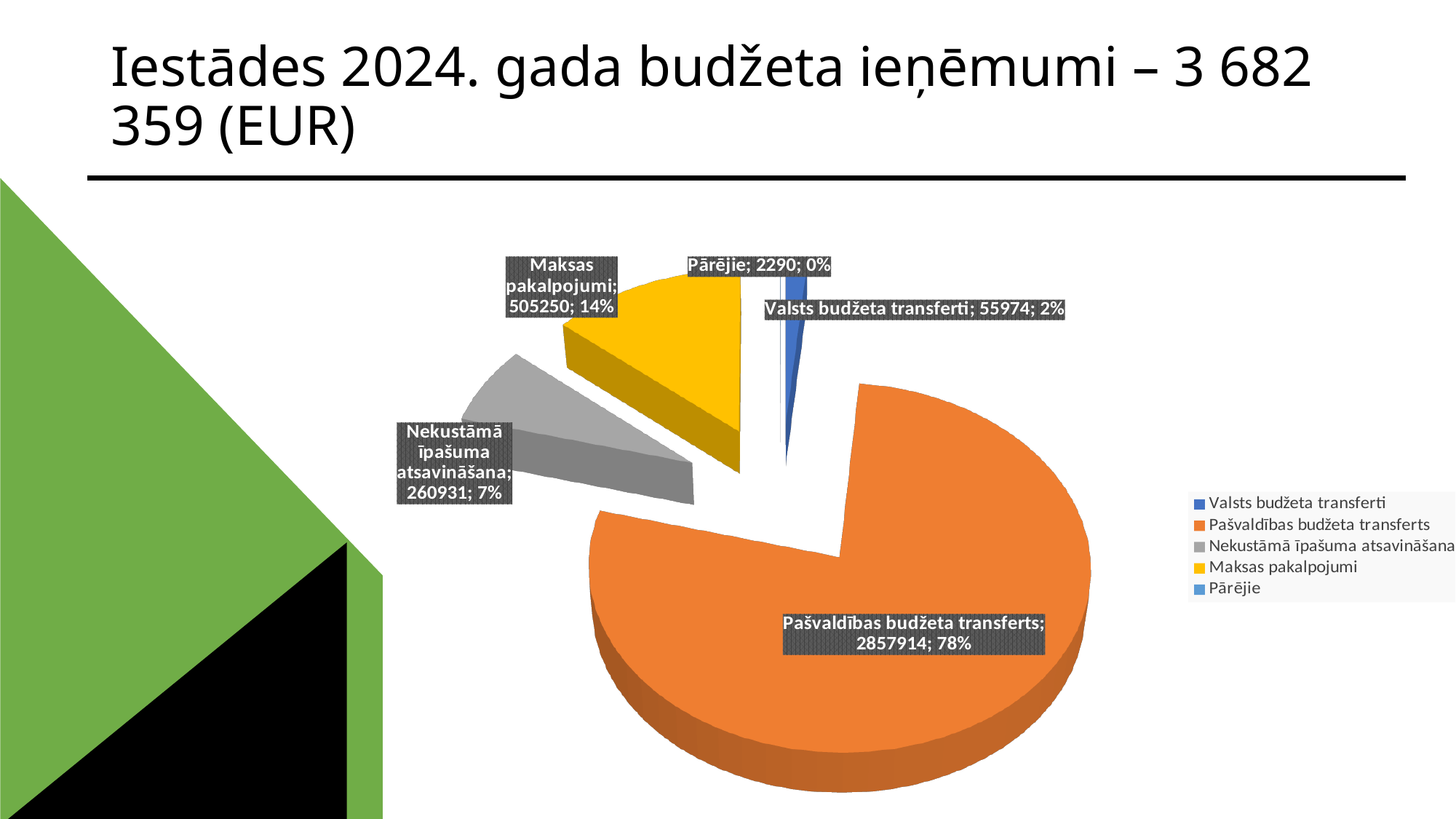
What share of the pie does Maksas pakalpojumi represent? 14% What share of the pie does Pašvaldības budžeta transferts represent? 78% Which category has the smallest slice? Pārējie What is the value for Nekustāmā īpašuma atsavināšana? 260931 Which category has the largest slice? Pašvaldības budžeta transferts What is the value for Valsts budžeta transferti? 55974 What is the value for Pašvaldības budžeta transferts? 2857914 How many categories does the legend list? 5 What kind of chart is shown on the slide? Pie chart What is the difference between the values for Maksas pakalpojumi and Nekustāmā īpašuma atsavināšana? 244319 Which is larger, the value for Valsts budžeta transferti or the value for Pārējie? Valsts budžeta transferti What is the value for Maksas pakalpojumi? 505250